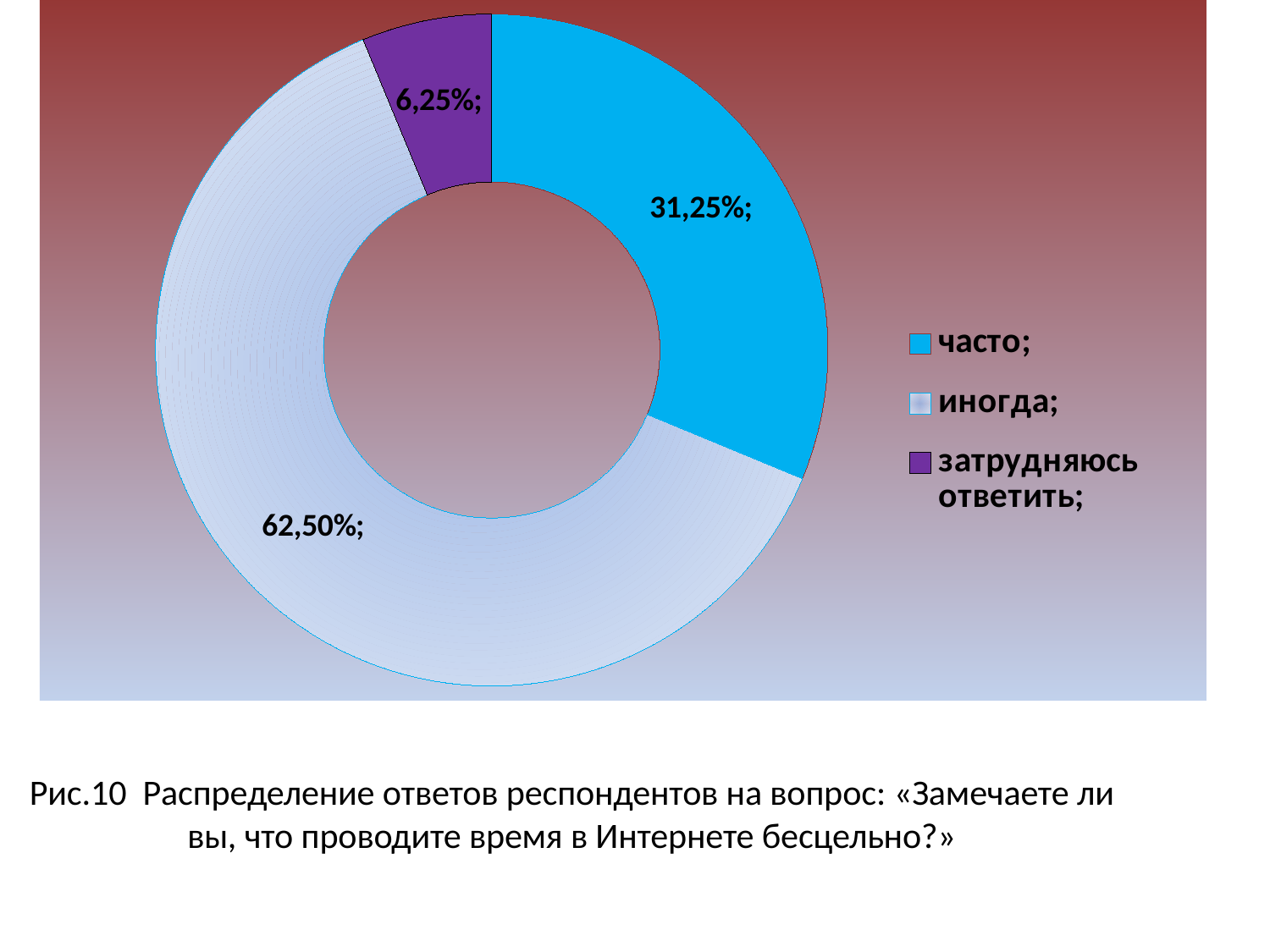
Which colour represents «затрудняюсь ответить» in the legend? purple What share of respondents answered «часто»? 31,25% What share of respondents answered «иногда»? 62,50% What is the figure number given in the caption below the chart? Рис.10 Which answer has the largest share? иногда What share of respondents answered «затрудняюсь ответить»? 6,25% What is the difference in percentage points between «иногда» and «часто»? 31,25 Which answer has the smallest share? затрудняюсь ответить What kind of chart is shown on the slide? doughnut (pie) chart What is the difference in percentage points between «часто» and «затрудняюсь ответить»? 25 Which is larger: the share for «часто» or for «затрудняюсь ответить»? часто How many categories does the chart show? 3